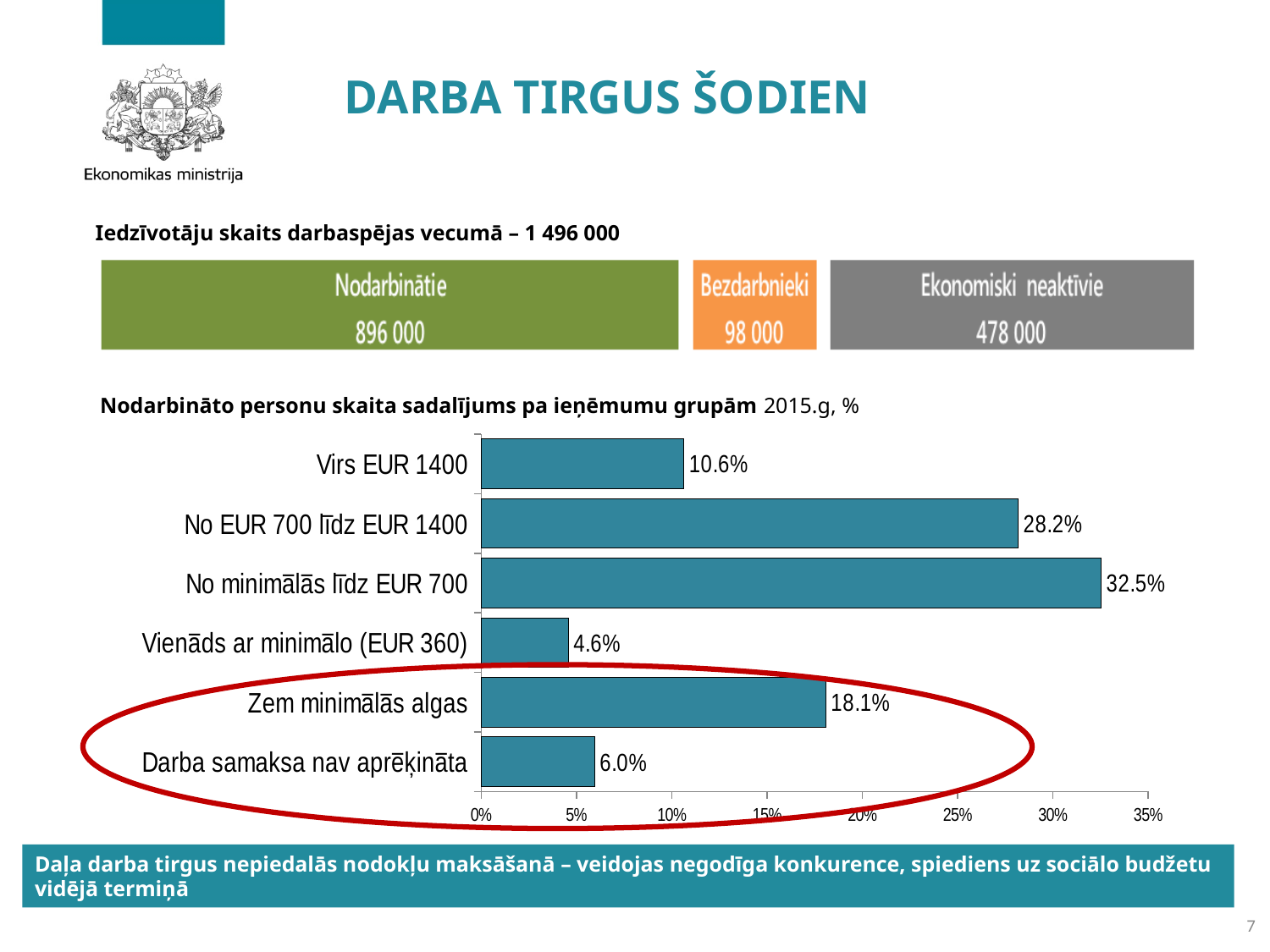
Which income group has the lowest share? Vienāds ar minimālo (EUR 360) What is the value for "Zem minimālās algas"? 18.1% Which is larger: the value for "Zem minimālās algas" or the value for "Virs EUR 1400"? Zem minimālās algas What is the value for "Darba samaksa nav aprēķināta"? 6.0% Which income group has the highest share? No minimālās līdz EUR 700 What is the highest value shown on the x axis of the bar chart? 35% What is the combined value of the two circled categories, "Zem minimālās algas" and "Darba samaksa nav aprēķināta"? 24.1% What is the value for "Virs EUR 1400"? 10.6% What is the value for "No EUR 700 līdz EUR 1400"? 28.2% What type of chart is used to show the distribution of employed persons by income group? Bar chart What is the difference between the values for "No minimālās līdz EUR 700" and "No EUR 700 līdz EUR 1400"? 4.3% How many income groups are shown in the bar chart? 6